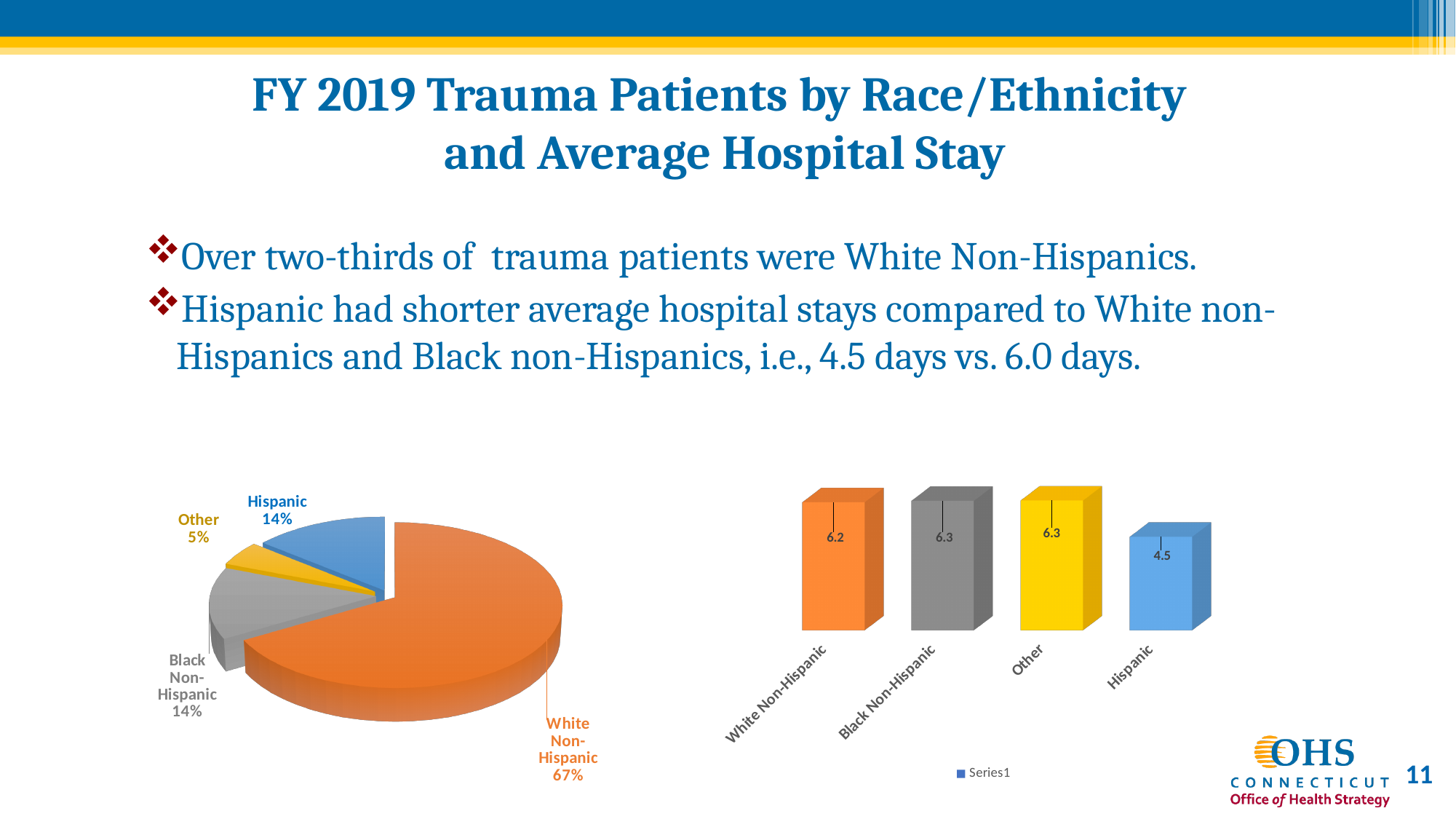
What type of chart is shown on the right side of the slide? Bar chart In the pie chart on the left, how many slices are there? 4 In the pie chart on the left, which race/ethnicity category has the smallest slice? Other In the pie chart on the left, which race/ethnicity category has the largest slice? White Non-Hispanic In the pie chart on the left, what percentage of trauma patients were in the Other category? 5% In the pie chart on the left, what share of trauma patients were White Non-Hispanic? 67% In the bar chart on the right, which category has the lowest value? Hispanic In the bar chart on the right, what is the value for Hispanic? 4.5 In the bar chart on the right, what is the value for White Non-Hispanic? 6.2 In the bar chart on the right, what is the difference between the values for Black Non-Hispanic and Hispanic? 1.8 In the pie chart on the left, what is the difference in percentage points between the White Non-Hispanic and Hispanic slices? 53 In the bar chart on the right, what is the legend entry shown below the chart? Series1